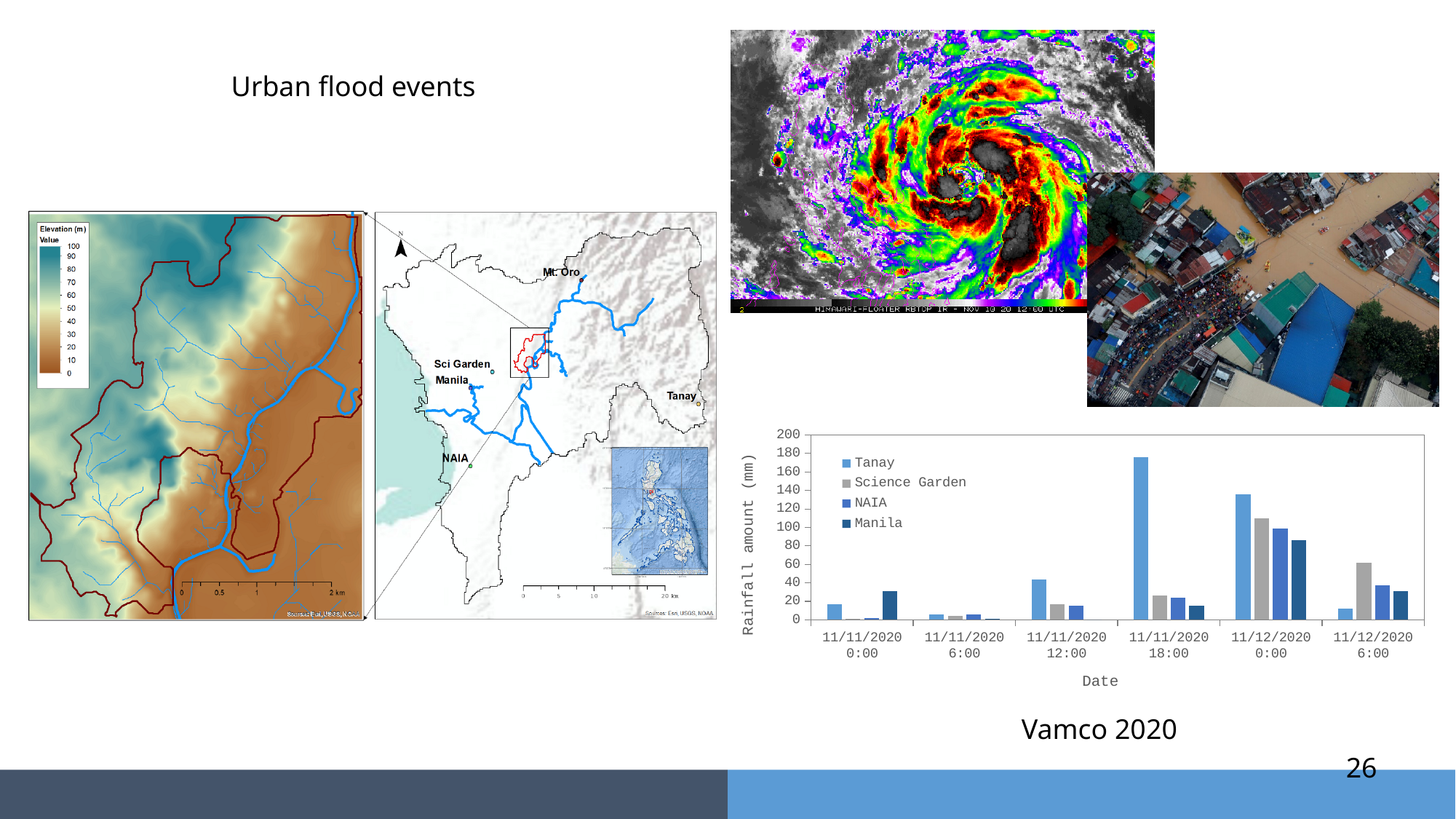
How many series does the legend of the rainfall chart list? 4 How many date/time categories are shown on the x axis of the rainfall chart? 6 What kind of chart is the rainfall chart on the slide? bar chart What is the y-axis label of the rainfall chart? Rainfall amount (mm) In the rainfall chart, at which date and time does Tanay have its highest rainfall amount? 11/11/2020 18:00 In the rainfall chart, is the Science Garden value at 11/12/2020 0:00 greater or less than 100? greater In the rainfall chart, at 11/12/2020 6:00, which is larger: Science Garden or Tanay? Science Garden In the rainfall chart, is the Tanay value at 11/11/2020 18:00 greater or less than 160? greater In the rainfall chart, is the Manila value at 11/12/2020 0:00 greater or less than 100? less In the rainfall chart, which station has the lowest rainfall amount at 11/12/2020 6:00? Tanay In the rainfall chart, at 11/11/2020 0:00, which is larger: Manila or Tanay? Manila